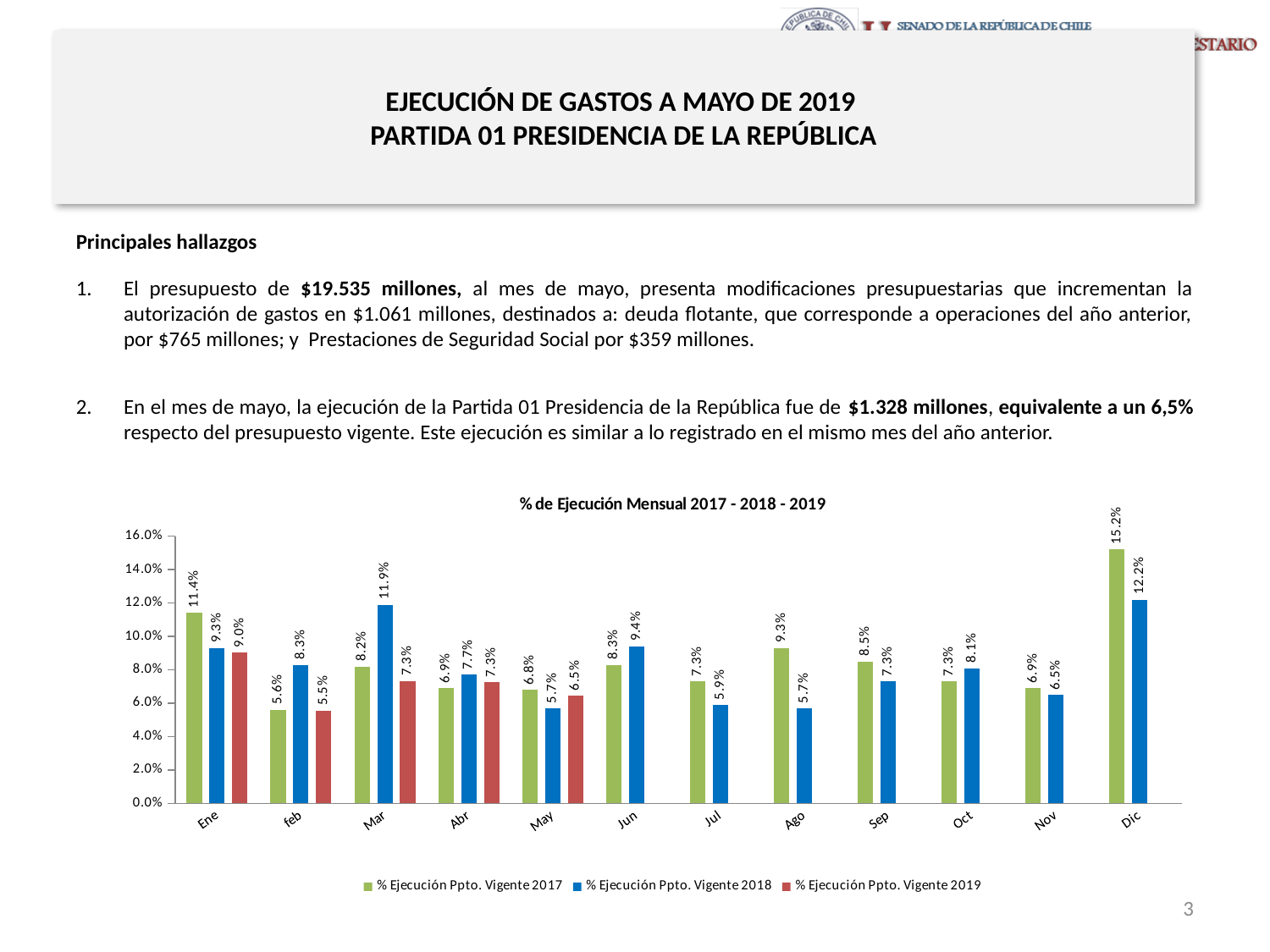
What is the difference between the 2017 and 2018 values in Ene? 2.1% Which month has the highest value for % Ejecución Ppto. Vigente 2018? Dic What is the value for % Ejecución Ppto. Vigente 2019 in May? 6.5% Which is larger in Ago: the 2017 value or the 2018 value? 2017 (9.3%) What is the value for % Ejecución Ppto. Vigente 2017 in Dic? 15.2% What is the value for % Ejecución Ppto. Vigente 2018 in Mar? 11.9% How many months are shown on the x axis? 12 How many series does the legend list? 3 Which month has the lowest value for % Ejecución Ppto. Vigente 2019? feb Is the value for % Ejecución Ppto. Vigente 2017 in Ene greater or less than 10.0%? greater What kind of chart is shown? Bar chart What is the title of the chart? % de Ejecución Mensual 2017 - 2018 - 2019